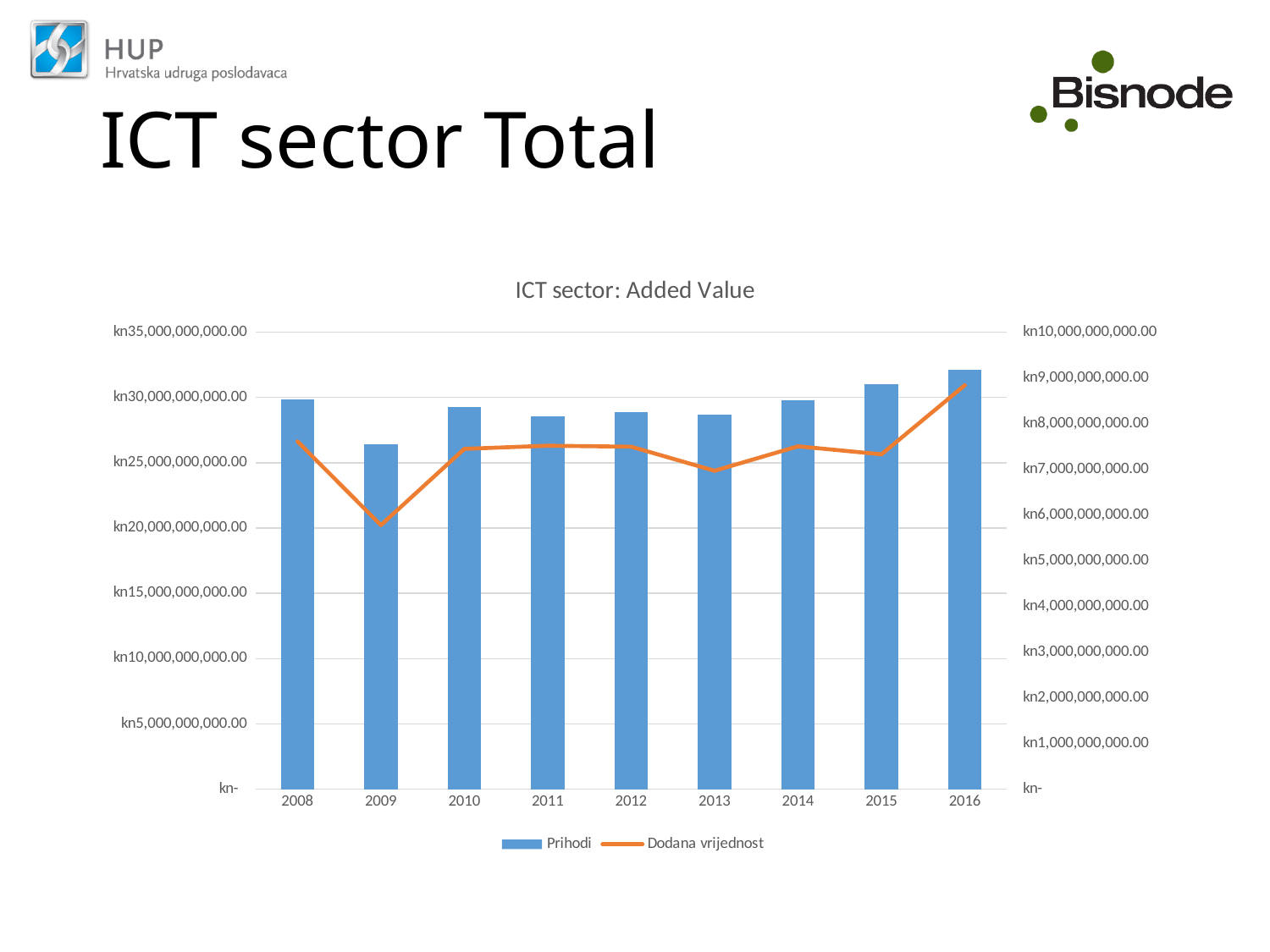
Is the Dodana vrijednost value for 2016 greater or less than kn8,000,000,000.00? greater In which year does the Dodana vrijednost line reach its lowest point? 2009 In which year is the Prihodi bar the highest? 2016 What kind of chart is used for the Prihodi series? Bar chart What is the title of the chart? ICT sector: Added Value In which year does the Dodana vrijednost line reach its highest point? 2016 In which year is the Prihodi bar the lowest? 2009 Which year has the larger Prihodi value, 2010 or 2015? 2015 Which series is drawn as a line in the chart? Dodana vrijednost How many series does the chart legend list? 2 How many years are shown on the x axis of the chart? 9 Is the Prihodi value for 2009 greater or less than kn30,000,000,000.00? less